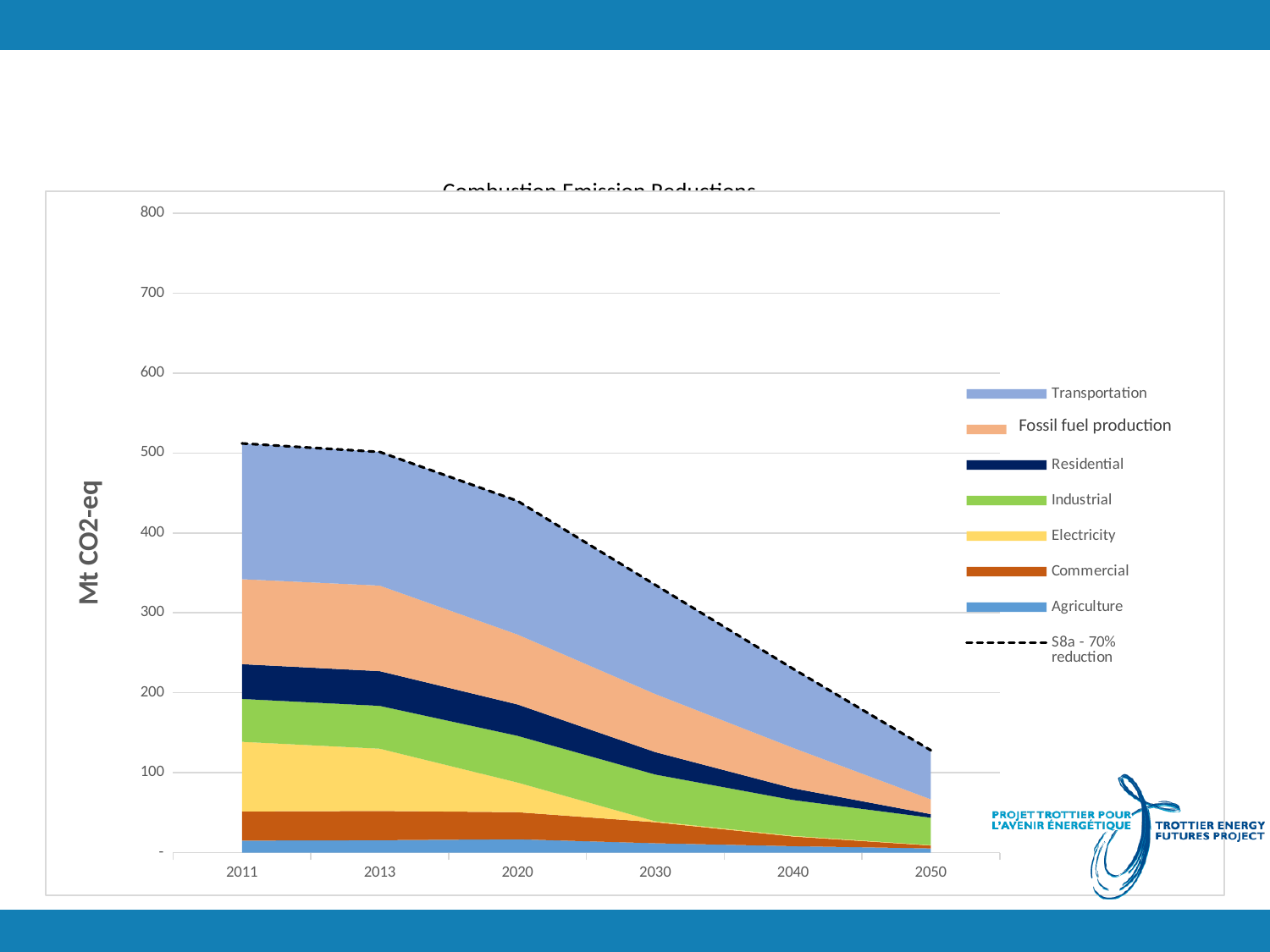
Is the total emissions value for 2050 greater or less than 200 Mt CO2-eq? less Which year on the x axis has the highest total emissions? 2011 What is the label on the y axis of the chart? Mt CO2-eq Is the total emissions value for 2020 greater or less than 400 Mt CO2-eq? greater Do total combustion emissions rise or fall from 2011 to 2050 in the chart? Fall What does the dashed black line in the chart represent, according to the legend? S8a - 70% reduction How many entries does the chart's legend list? 8 What kind of chart is shown on the slide? Stacked area chart Is the total emissions value for 2040 greater or less than 300 Mt CO2-eq? less How many years are labelled along the x axis of the chart? 6 Which year on the x axis has the lowest total emissions? 2050